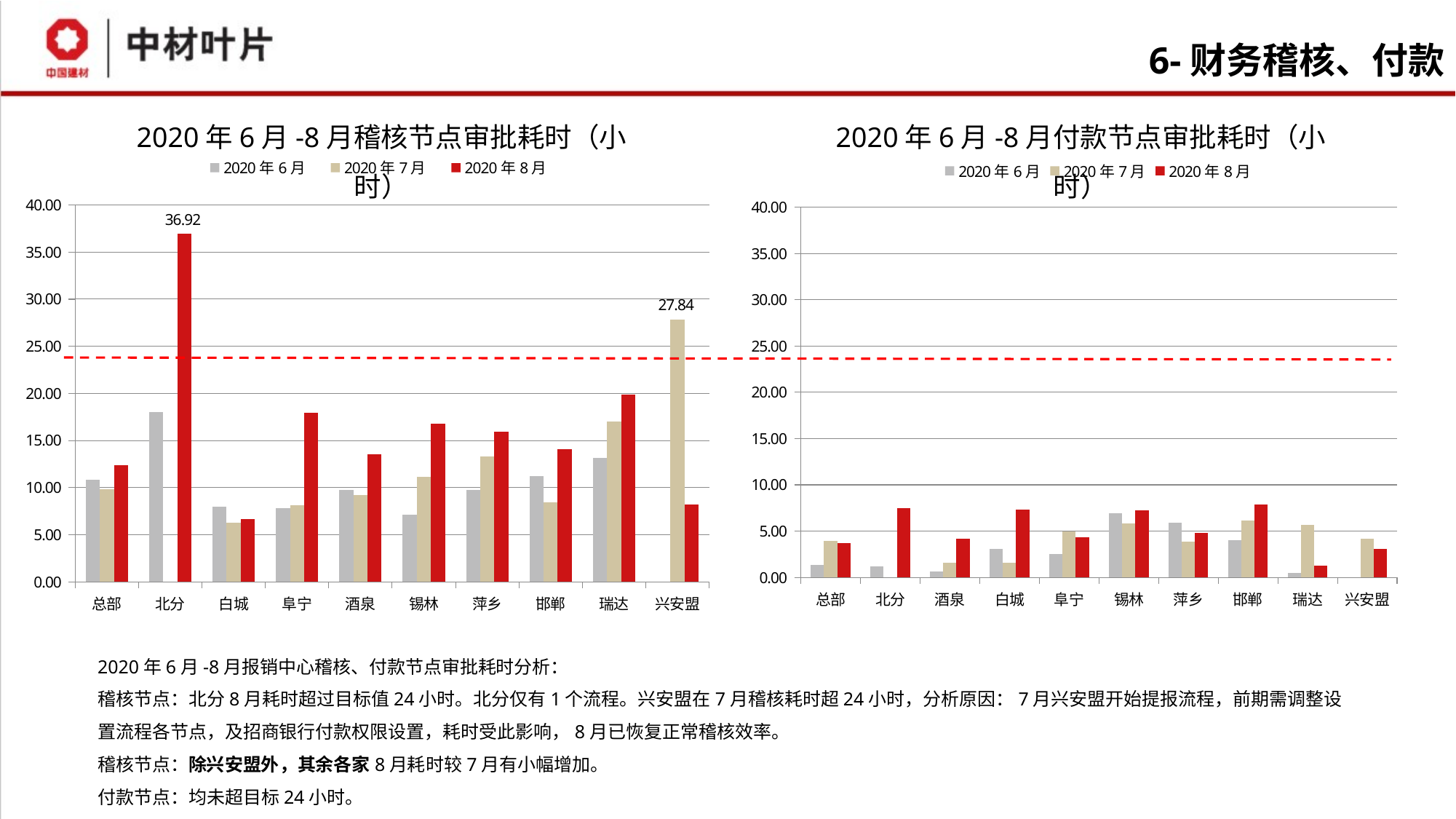
In the left chart (2020年6月-8月稽核节点审批耗时), what is the difference between the labelled 北分 2020年8月 value and the labelled 兴安盟 2020年7月 value? 9.08 In the left chart (2020年6月-8月稽核节点审批耗时), is the value for 北分 in the 2020年6月 series greater or less than 15.00? greater In the left chart (2020年6月-8月稽核节点审批耗时), what is the value for 兴安盟 in the 2020年7月 series? 27.84 In the left chart (2020年6月-8月稽核节点审批耗时), which category has the highest 2020年8月 value? 北分 What kind of chart is the right chart (2020年6月-8月付款节点审批耗时)? bar chart How many series does the legend of the left chart (2020年6月-8月稽核节点审批耗时) list? 3 In the left chart (2020年6月-8月稽核节点审批耗时), which category has the lowest 2020年8月 value? 白城 In the left chart (2020年6月-8月稽核节点审批耗时), what is the value for 北分 in the 2020年8月 series? 36.92 How many categories are shown on the x axis of the right chart (2020年6月-8月付款节点审批耗时)? 10 In the right chart (2020年6月-8月付款节点审批耗时), which category has the lowest 2020年8月 value? 瑞达 In the left chart (2020年6月-8月稽核节点审批耗时), which is larger for 瑞达: the 2020年7月 value or the 2020年8月 value? 2020年8月 In the right chart (2020年6月-8月付款节点审批耗时), is the value for 北分 in the 2020年8月 series greater or less than 5.00? greater